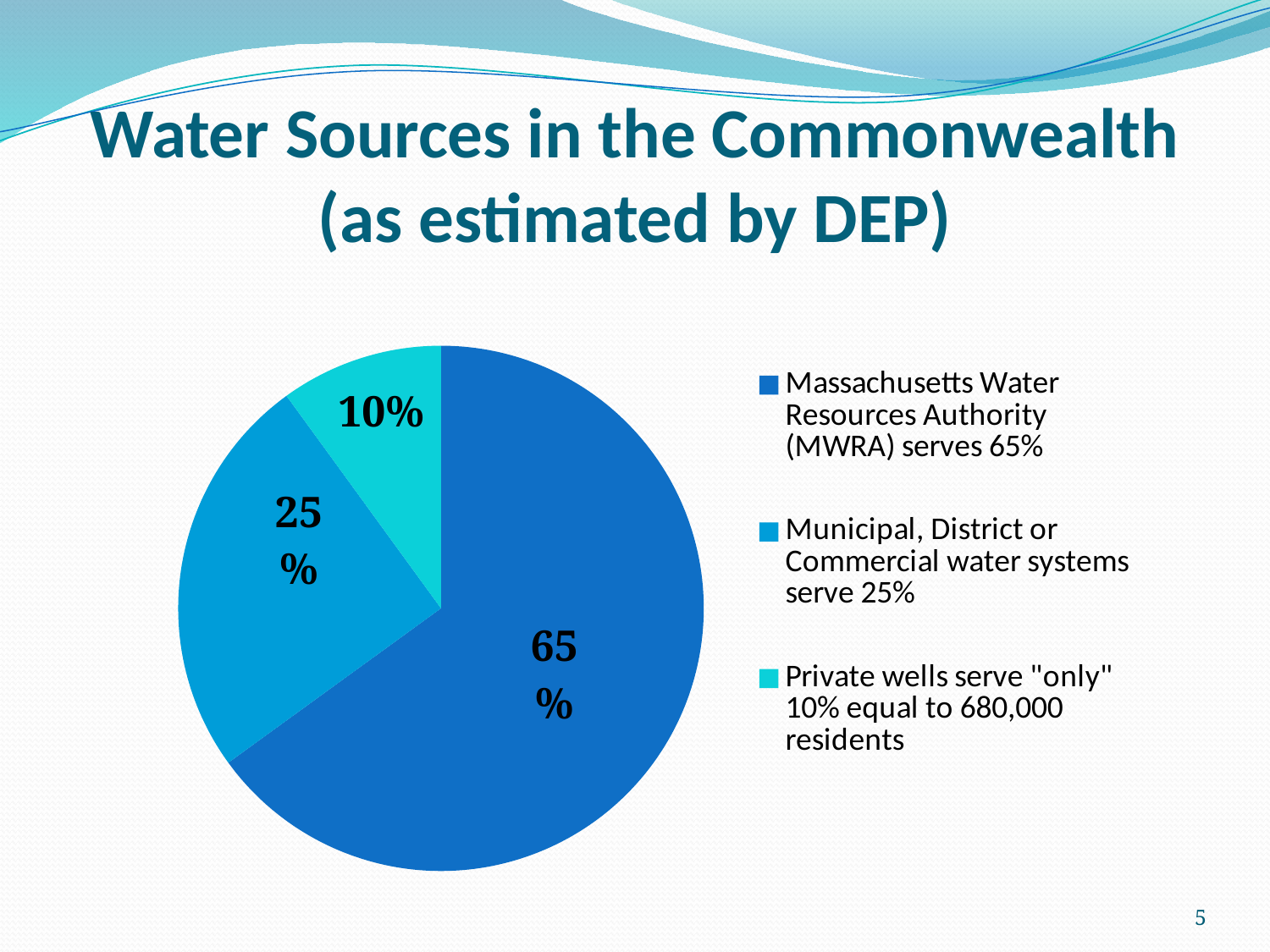
What kind of chart is shown on the slide? pie chart What share of the pie does the Massachusetts Water Resources Authority (MWRA) slice represent? 65% How many entries does the legend list? 3 Which water source has the largest slice of the pie? Massachusetts Water Resources Authority (MWRA) What is the difference in percentage points between the Municipal, District or Commercial water systems slice and the Private wells slice? 15 How many slices does the pie chart have? 3 What share of the pie does the Municipal, District or Commercial water systems slice represent? 25% According to the legend, how many residents are served by private wells? 680,000 Which is larger: the Municipal, District or Commercial water systems slice or the Private wells slice? Municipal, District or Commercial water systems Which water source has the smallest slice of the pie? Private wells What share of the pie does the Private wells slice represent? 10% What is the difference in percentage points between the MWRA slice and the Municipal, District or Commercial water systems slice? 40